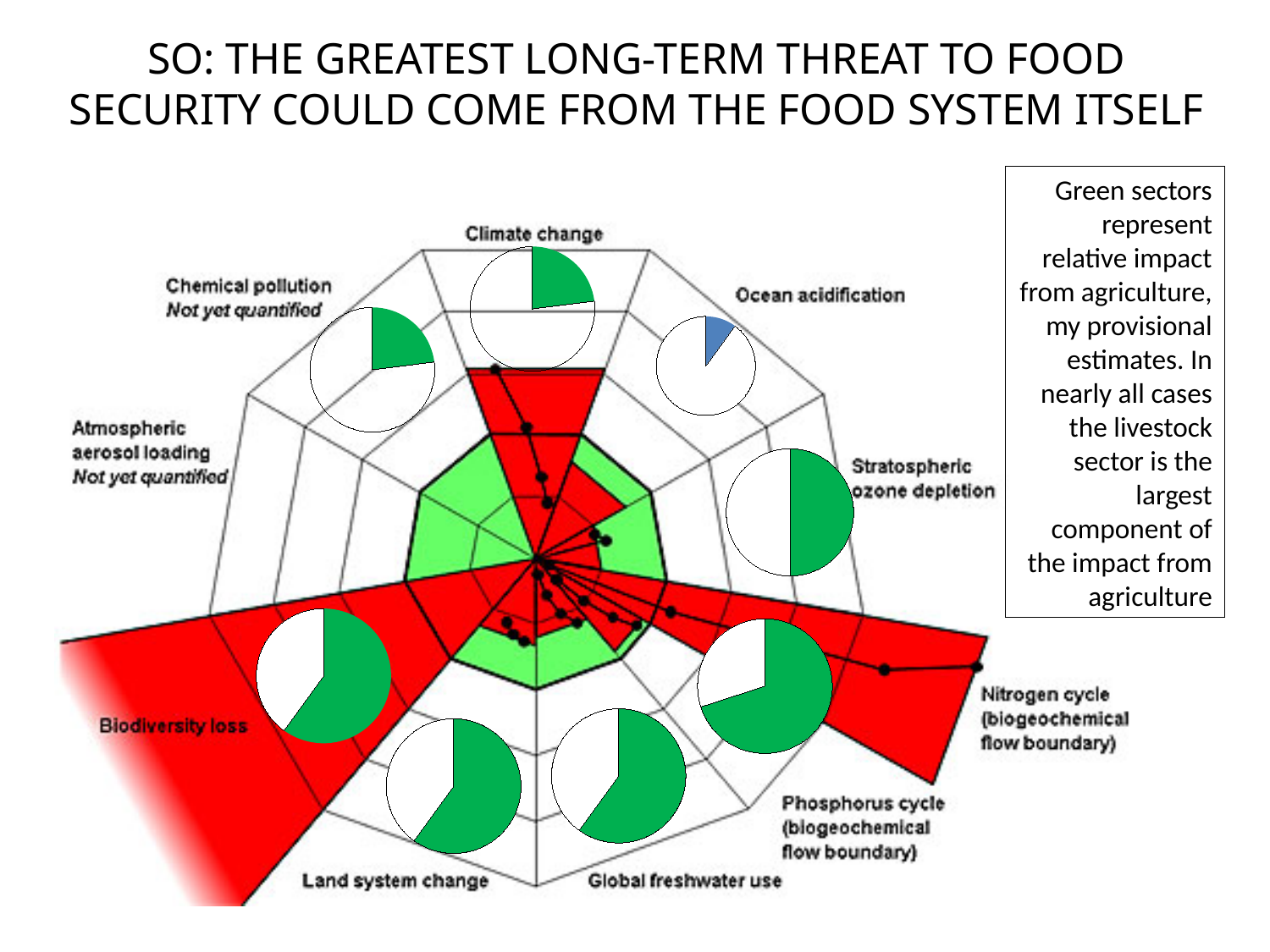
Which pie chart has the larger filled slice: Ocean acidification or Global freshwater use? Global freshwater use Which category's pie chart has the smallest filled slice? Ocean acidification What kind of small charts are overlaid on the planetary boundaries diagram? Pie charts Which two categories on the diagram are labelled 'Not yet quantified'? Chemical pollution and Atmospheric aerosol loading Which pie chart has the larger filled slice: Ocean acidification or Climate change? Climate change What colour is the filled slice in the Ocean acidification pie chart? Blue According to the text box, what do the green sectors of the pie charts represent? Relative impact from agriculture How many pie charts are shown on the diagram? 8 Which pie chart has the larger filled slice: Chemical pollution or Biodiversity loss? Biodiversity loss